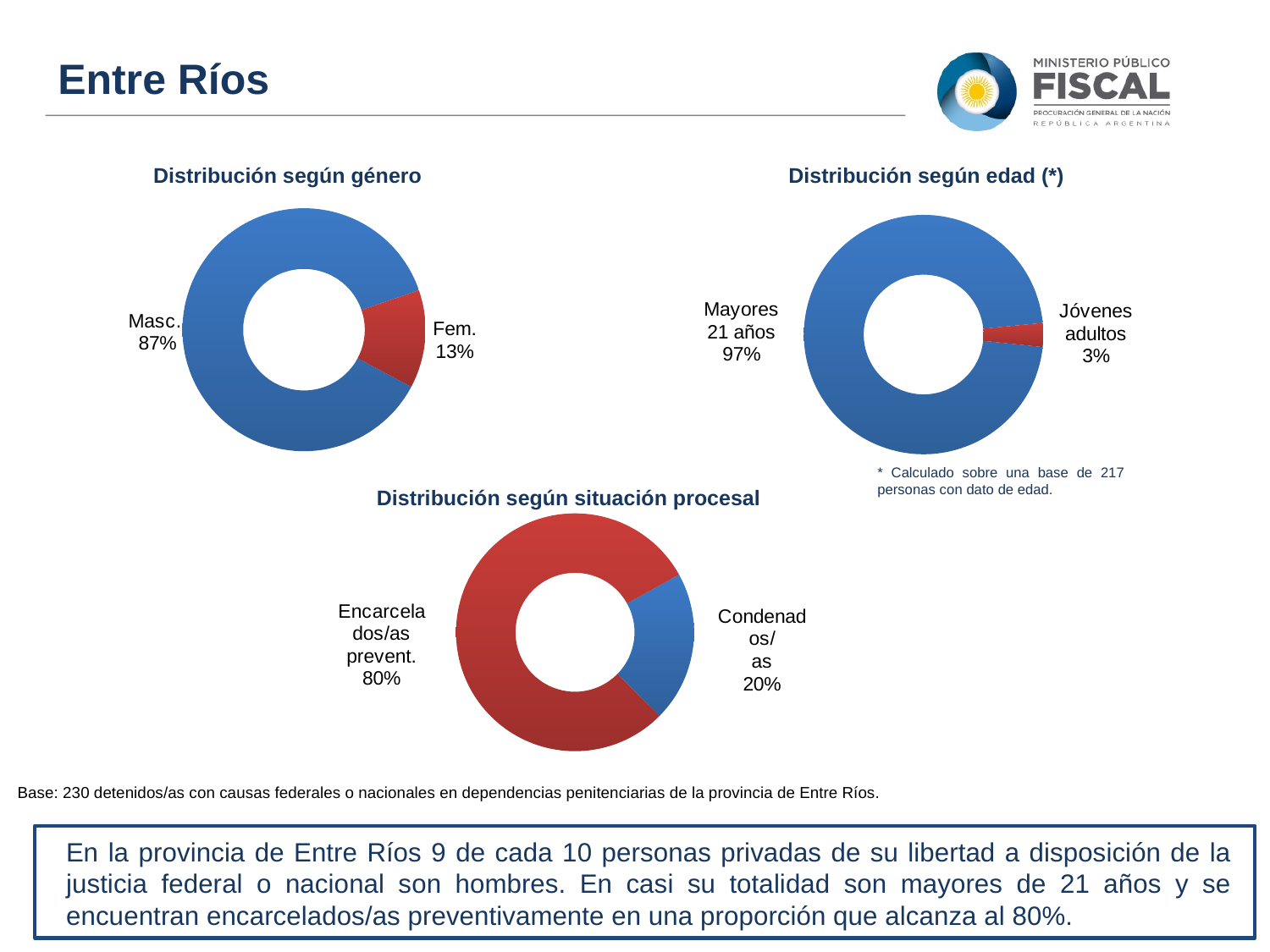
In the 'Distribución según situación procesal' chart, what is the difference in percentage points between Encarcelados/as prevent. and Condenados/as? 60 In the 'Distribución según género' chart, what share is labelled for Fem.? 13% In the 'Distribución según edad (*)' chart, which category has the smallest share? Jóvenes adultos In the 'Distribución según edad (*)' chart, what share is labelled for Mayores 21 años? 97% In the 'Distribución según género' chart, what share is labelled for Masc.? 87% In the 'Distribución según situación procesal' chart, what share is labelled for Condenados/as? 20% In the 'Distribución según género' chart, which category has the largest share? Masc. How many charts are shown on the slide? 3 In the 'Distribución según género' chart, how many categories are shown? 2 In the 'Distribución según situación procesal' chart, what share is labelled for Encarcelados/as prevent.? 80% What kind of chart is 'Distribución según situación procesal'? Pie chart (donut) In the 'Distribución según edad (*)' chart, what share is labelled for Jóvenes adultos? 3%